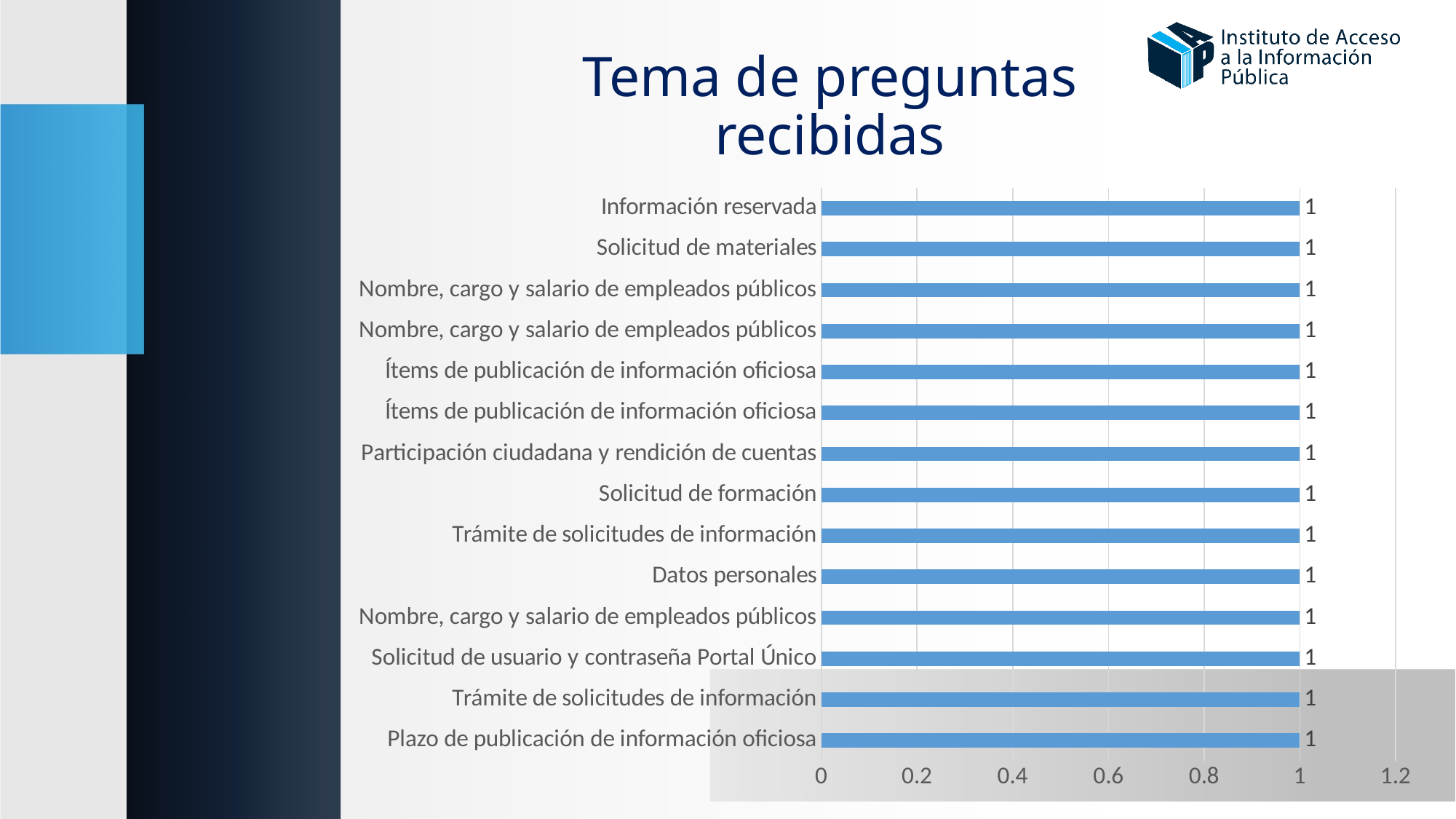
What is the difference between the values for Solicitud de materiales and Solicitud de formación? 0 How many categories (bars) does the chart show? 14 What is the value for Información reservada? 1 What is the value for Plazo de publicación de información oficiosa? 1 What is the value for Solicitud de usuario y contraseña Portal Único? 1 What is the title of the chart? Tema de preguntas recibidas What is the value for Participación ciudadana y rendición de cuentas? 1 What is the highest value shown on the horizontal axis? 1.2 What kind of chart is shown on the slide? bar chart Is the value for Solicitud de formación greater or less than 1.2? less Is the value for Datos personales greater or less than 0.8? greater What is the value for Datos personales? 1